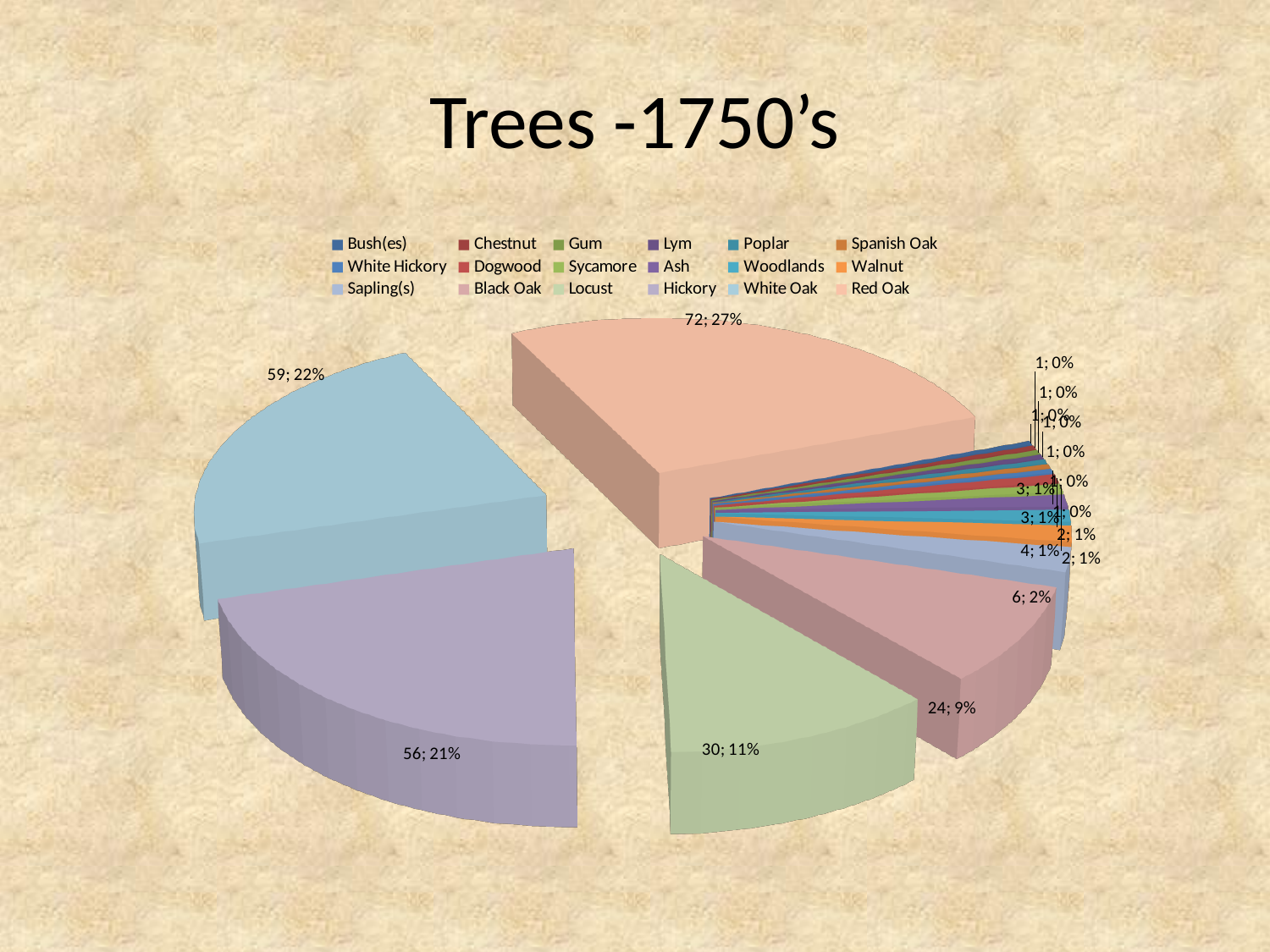
Which is larger, the White Oak slice or the Hickory slice? White Oak What share of the pie does the Black Oak slice represent? 9% What share of the pie does the Red Oak slice represent? 27% What value is shown for the White Oak slice? 59 What is the difference between the Red Oak value (72) and the White Oak value (59)? 13 What value is shown for the Locust slice? 30 What is the title of the chart? Trees -1750's What share of the pie does the Hickory slice represent? 21% Which category has the largest slice of the pie? Red Oak How many categories does the legend list? 18 What is the value and percentage shown on the largest slice of the pie? 72; 27% What kind of chart is shown on the slide? pie chart